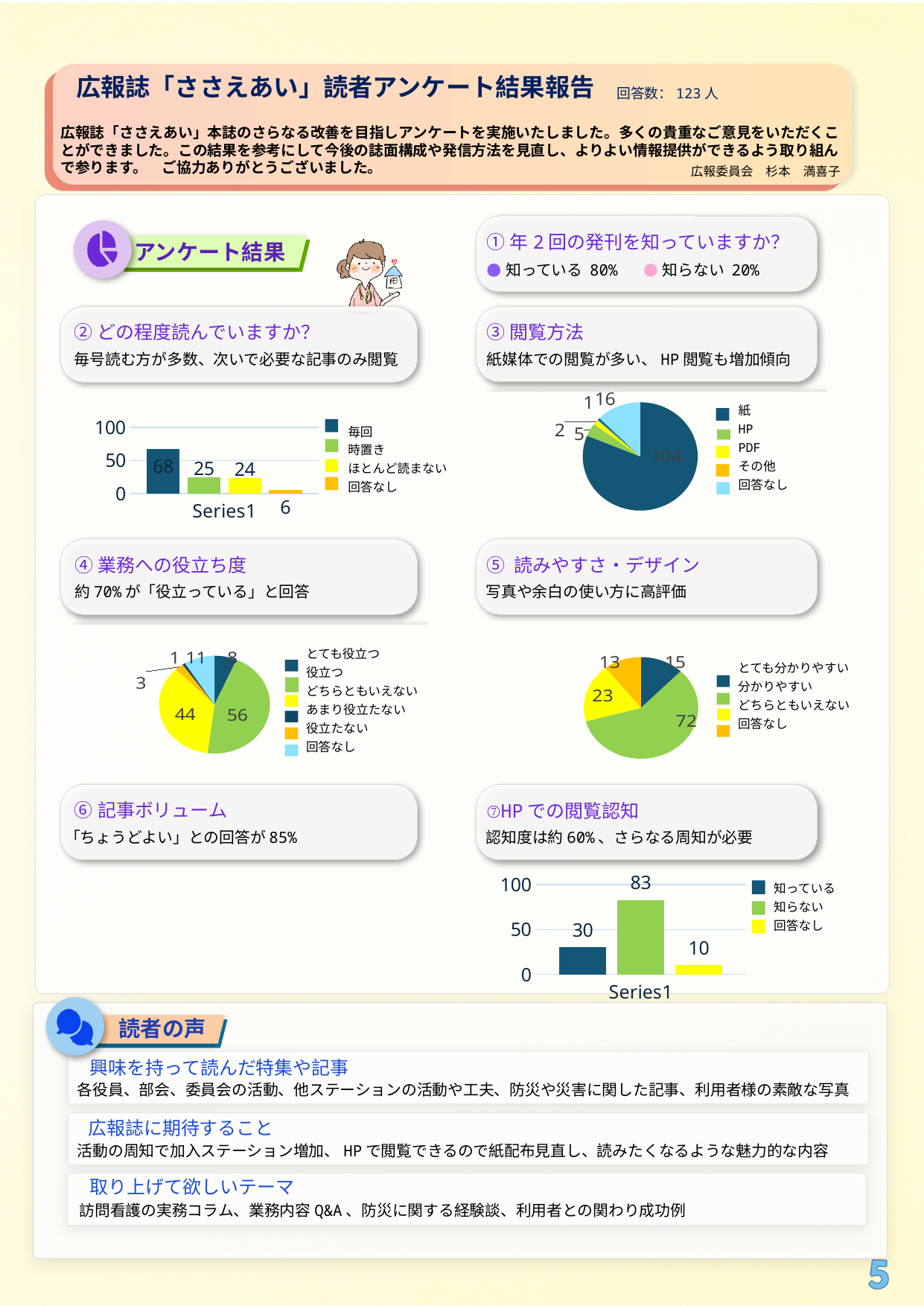
In the bar chart under ⑦HP での閲覧認知, what is the difference between 知らない and 知っている? 53 In the chart under ② どの程度読んでいますか?, what is the difference between 毎回 and 時置き? 43 In the bar chart under ⑦HP での閲覧認知, what is the value for 知らない? 83 In the pie chart under ④ 業務への役立ち度, what is the value for 役立つ? 56 In the chart under ② どの程度読んでいますか?, what is the value for 毎回? 68 In the pie chart under ③ 閲覧方法, what is the value for 紙? 104 What kind of chart is shown under ② どの程度読んでいますか? bar chart In the chart under ② どの程度読んでいますか?, which category has the lowest value? 回答なし In the pie chart under ④ 業務への役立ち度, which category has the largest slice? 役立つ In the pie chart under ⑤ 読みやすさ・デザイン, which is larger, どちらともいえない or 回答なし? どちらともいえない In the pie chart under ⑤ 読みやすさ・デザイン, what is the value for 分かりやすい? 72 How many entries does the legend of the pie chart under ③ 閲覧方法 list? 5